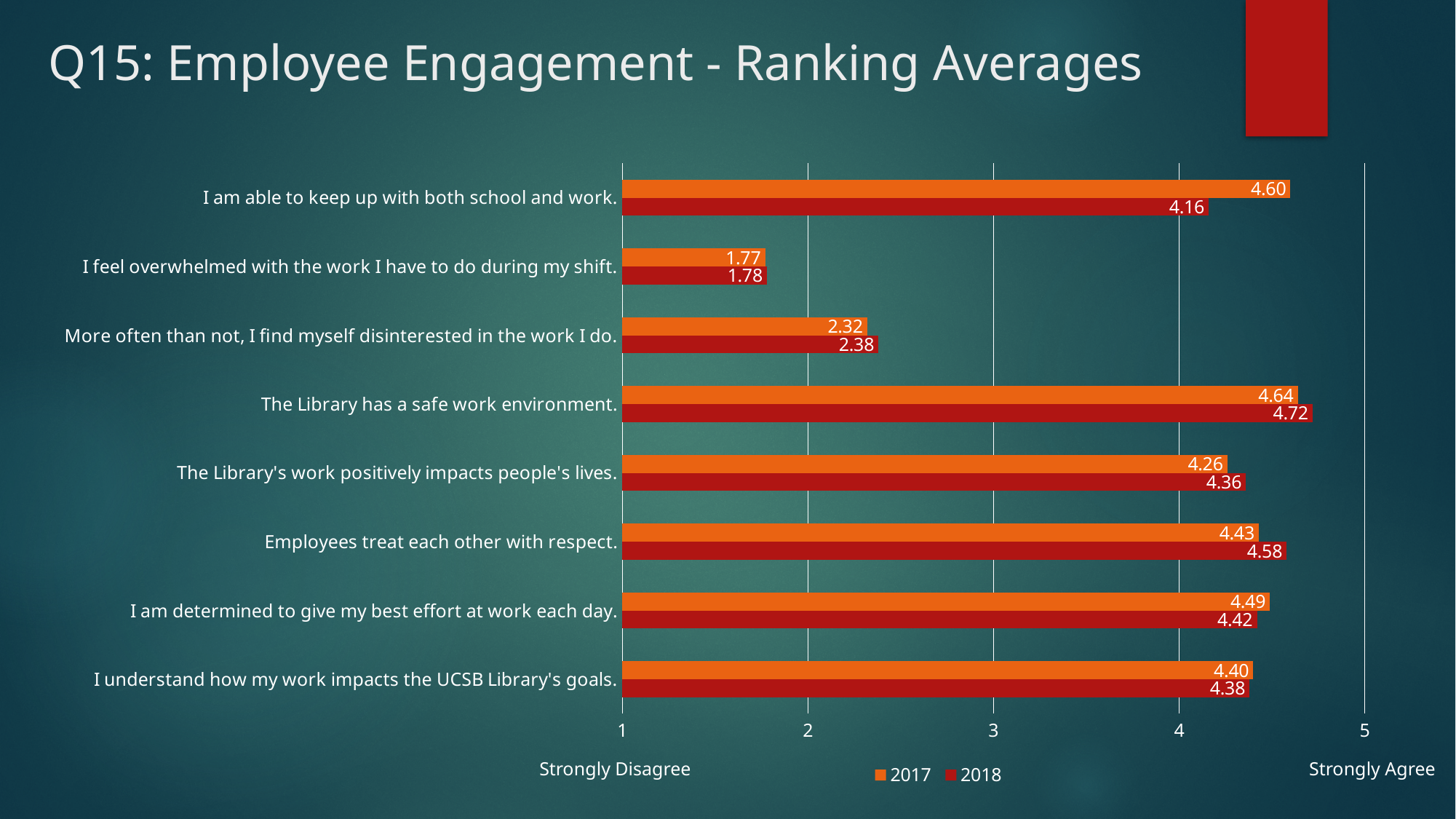
What is the 2018 value for "I feel overwhelmed with the work I have to do during my shift."? 1.78 What is the 2017 value for "I am able to keep up with both school and work."? 4.60 Which statement has the lowest 2017 value? I feel overwhelmed with the work I have to do during my shift. What kind of chart is shown on the slide? Bar chart What is the 2018 value for "The Library has a safe work environment."? 4.72 How many statements are listed on the chart? 8 What label appears at the right end of the x axis? Strongly Agree Is the 2018 value for "More often than not, I find myself disinterested in the work I do." greater or less than 3? less Which statement has the highest 2018 value? The Library has a safe work environment. What is the difference between the 2017 and 2018 values for "I am able to keep up with both school and work."? 0.44 For "Employees treat each other with respect.", which year has the larger value, 2017 or 2018? 2018 How many series does the legend list? 2